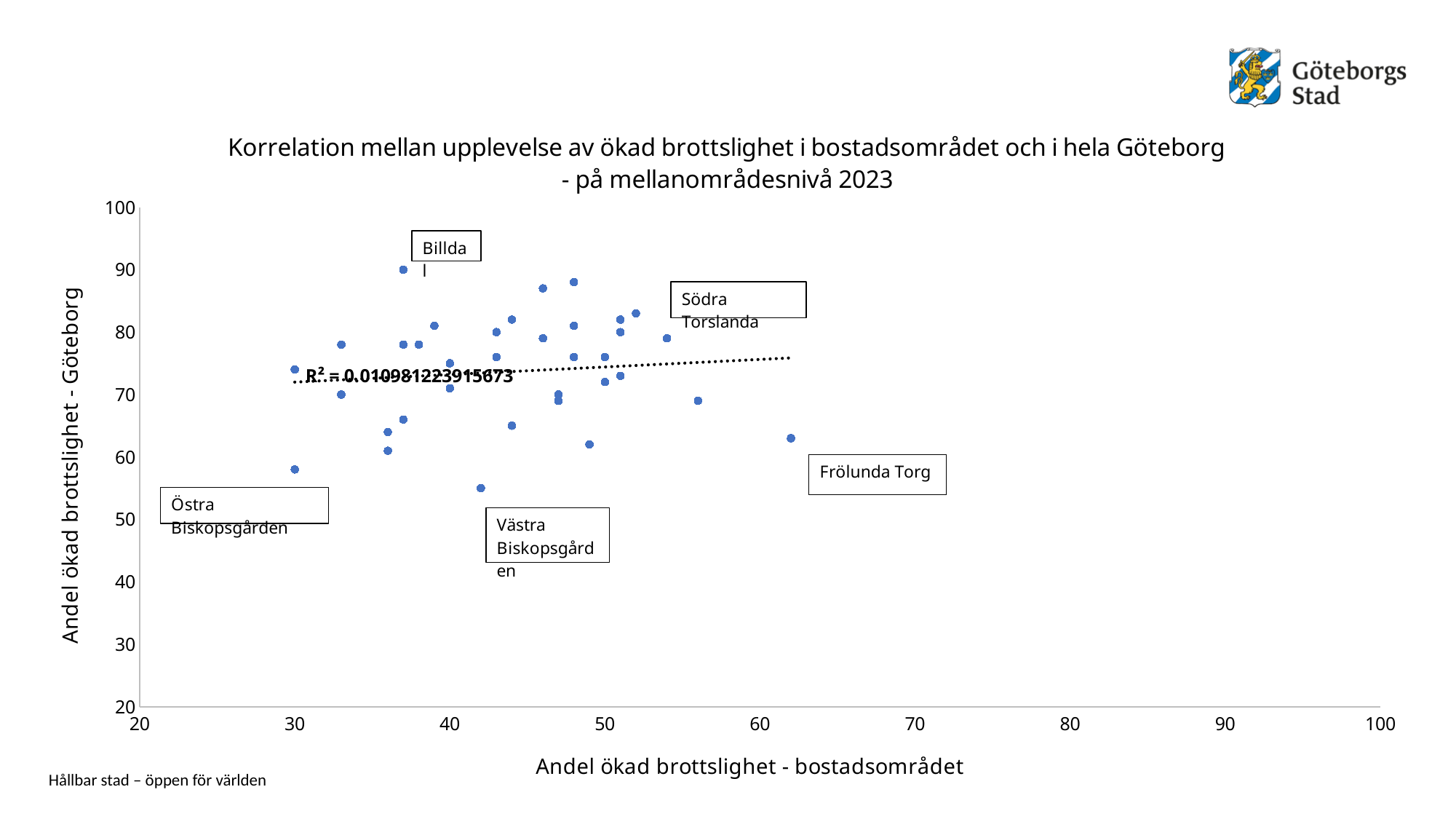
What R² value is printed on the chart? R² = 0.0109812239156673 Which has the larger x-axis value, Frölunda Torg or Östra Biskopsgården? Frölunda Torg Which labelled point has the highest value on the y axis? Billdal What is the title of the chart? Korrelation mellan upplevelse av ökad brottslighet i bostadsområdet och i hela Göteborg - på mellanområdesnivå 2023 Is the x-axis value for Östra Biskopsgården greater or less than 40? less Is the y-axis value for Frölunda Torg greater or less than 70? less Is the y-axis value for Västra Biskopsgården greater or less than 60? less Which labelled point has the lowest value on the y axis? Västra Biskopsgården What kind of chart is shown on the slide? Scatter chart What is the label of the x axis? Andel ökad brottslighet - bostadsområdet